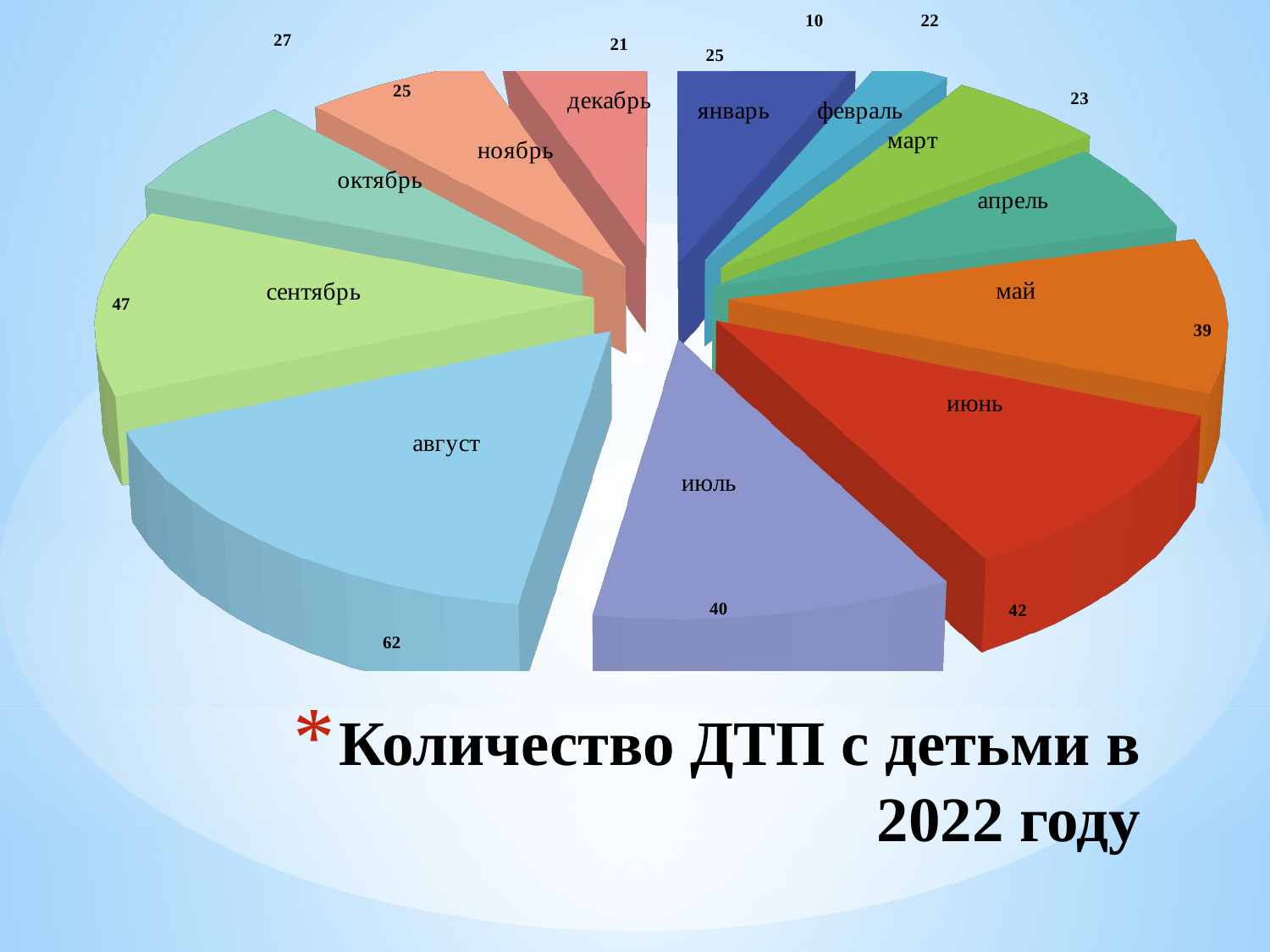
Which month has the largest slice in the pie chart? август How many slices (months) does the pie chart have? 12 What is the value for июнь (June) in the pie chart? 42 What is the value for август (August) in the pie chart? 62 What is the value for февраль (February) in the pie chart? 10 What is the difference between the values for август and сентябрь? 15 What kind of chart is shown on the slide? pie chart What is the value for сентябрь (September) in the pie chart? 47 Which month has the smallest slice in the pie chart? февраль What is the difference between the values for июнь and июль? 2 Which is larger, the value for май or the value for октябрь? май What is the title text shown on the slide for the chart? Количество ДТП с детьми в 2022 году